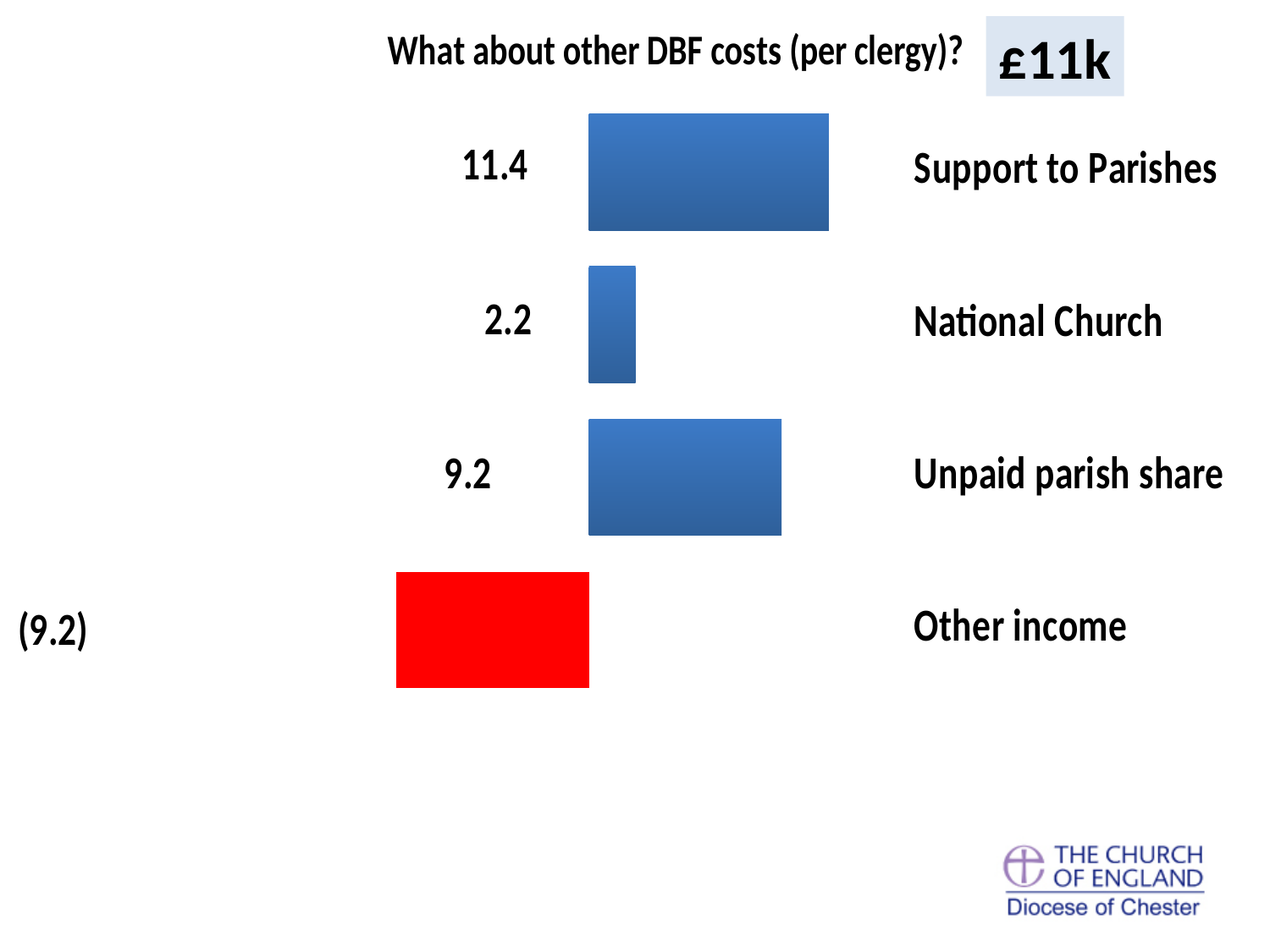
What is the value for National Church? 2.2 What is the difference between Support to Parishes and Unpaid parish share? 2.2 Which category has the highest value? Support to Parishes What is the value for Unpaid parish share? 9.2 Which is larger, Unpaid parish share or National Church? Unpaid parish share Which category has the lowest value? Other income What is the value for Support to Parishes? 11.4 Which category is shown with a red bar? Other income What is the difference between Support to Parishes and National Church? 9.2 What value is shown for Other income? (9.2) What kind of chart is shown on the slide? Bar chart How many categories are shown in the chart? 4